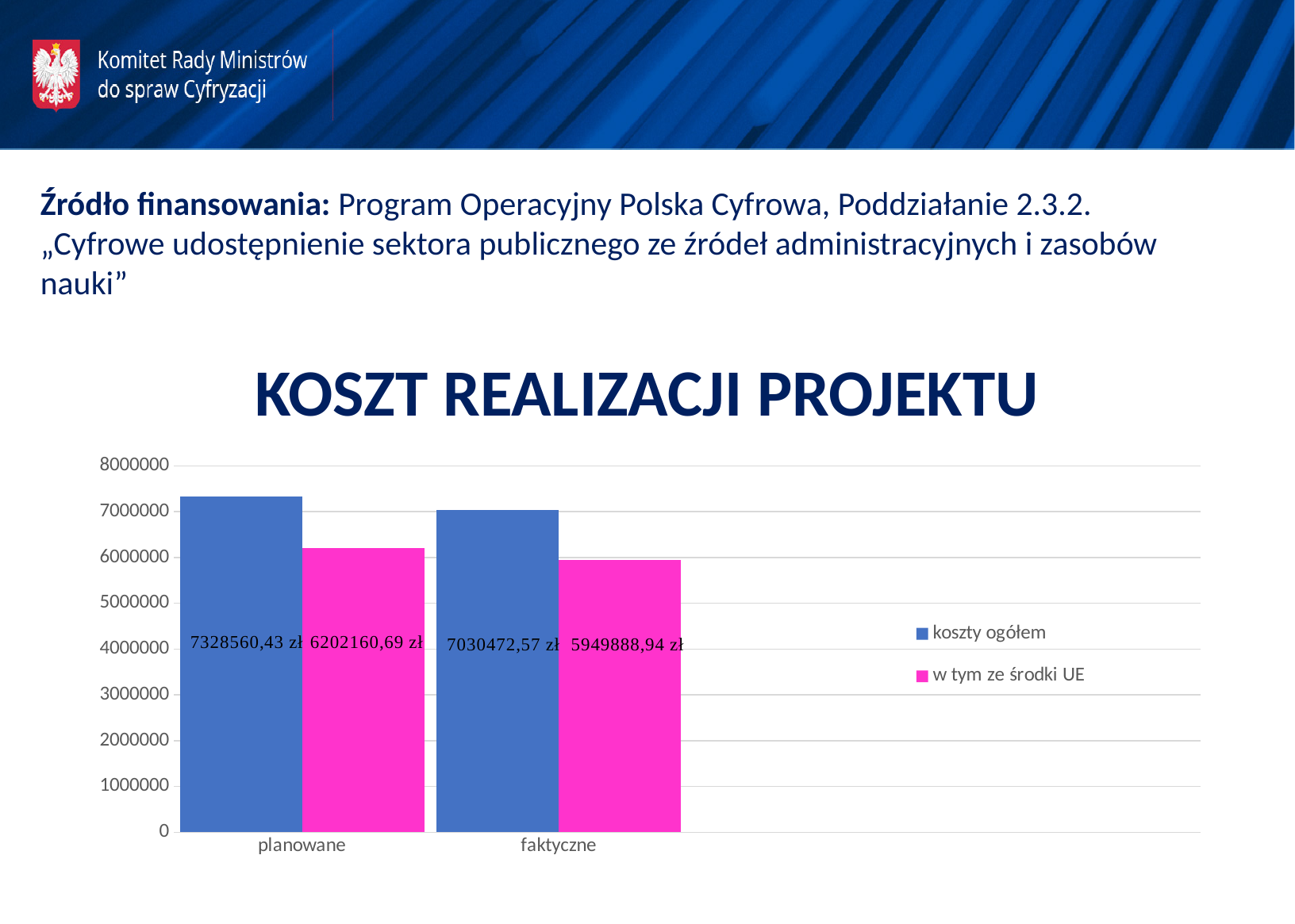
Which category has the highest koszty ogółem value? planowane Which category has the lowest w tym ze środki UE value? faktyczne Which is larger: w tym ze środki UE for planowane or w tym ze środki UE for faktyczne? planowane What is the difference between koszty ogółem for planowane and koszty ogółem for faktyczne? 298087,86 zł What is the value of w tym ze środki UE for planowane? 6202160,69 zł How many categories are shown on the x axis? 2 What is the difference between koszty ogółem and w tym ze środki UE for planowane? 1126399,74 zł What is the value of w tym ze środki UE for faktyczne? 5949888,94 zł What kind of chart is shown on the slide? bar chart What is the value of koszty ogółem for planowane? 7328560,43 zł What is the value of koszty ogółem for faktyczne? 7030472,57 zł How many series does the legend list? 2